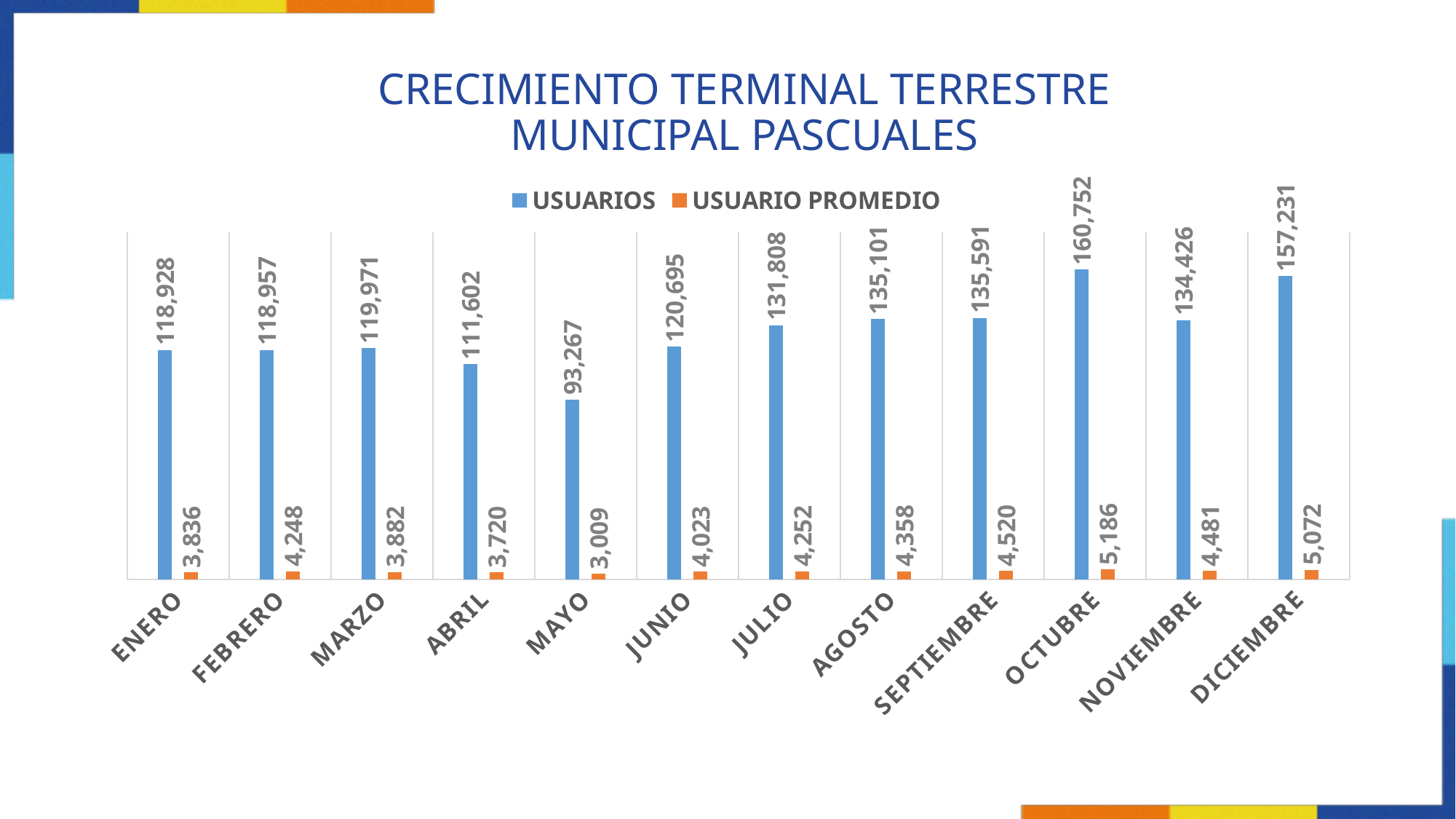
Which has a larger USUARIOS value, JUNIO or JULIO? JULIO Which month has the highest USUARIO PROMEDIO value? OCTUBRE How many series does the legend list? 2 How many months are shown on the x axis? 12 What is the difference between the USUARIOS values for OCTUBRE and DICIEMBRE? 3,521 What is the USUARIOS value for ABRIL? 111,602 Which month has the lowest USUARIOS value? MAYO What is the USUARIOS value for OCTUBRE? 160,752 What is the USUARIO PROMEDIO value for MAYO? 3,009 What kind of chart is shown on the slide? Bar chart Which month has the highest USUARIOS value? OCTUBRE What is the difference between the USUARIO PROMEDIO values for OCTUBRE and MAYO? 2,177